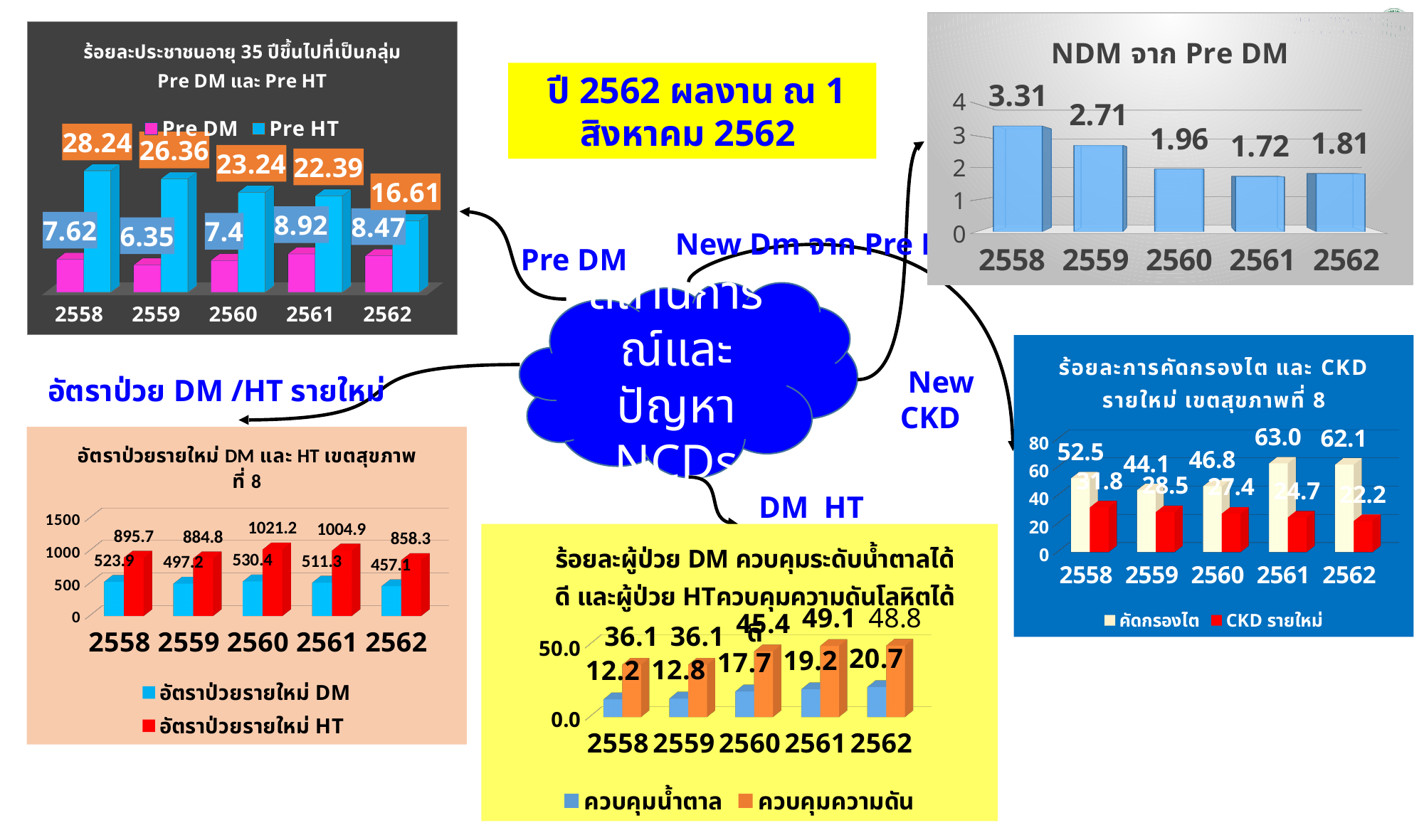
In the top-left chart 'ร้อยละประชาชนอายุ 35 ปีขึ้นไปที่เป็นกลุ่ม Pre DM และ Pre HT', do the Pre HT values rise or fall from 2558 to 2562? fall In the 'NDM จาก Pre DM' chart, what is the value for 2558? 3.31 In the top-left chart 'ร้อยละประชาชนอายุ 35 ปีขึ้นไปที่เป็นกลุ่ม Pre DM และ Pre HT', which year has the highest Pre DM value? 2561 In the 'NDM จาก Pre DM' chart, how many years are shown on the x axis? 5 In the bottom-left chart 'อัตราป่วยรายใหม่ DM และ HT เขตสุขภาพที่ 8', what is the difference between the HT and DM values for 2562? 401.2 In the bottom-middle chart 'ร้อยละผู้ป่วย DM ควบคุมระดับน้ำตาลได้ดี และผู้ป่วย HT ควบคุมความดันโลหิตได้', which year has the highest ควบคุมความดัน value? 2561 In the 'NDM จาก Pre DM' chart, which year has the lowest value? 2561 In the top-left chart 'ร้อยละประชาชนอายุ 35 ปีขึ้นไปที่เป็นกลุ่ม Pre DM และ Pre HT', what is the Pre HT value for 2562? 16.61 In the bottom-left chart 'อัตราป่วยรายใหม่ DM และ HT เขตสุขภาพที่ 8', what is the อัตราป่วยรายใหม่ HT value for 2560? 1021.2 In the right chart 'ร้อยละการคัดกรองไต และ CKD รายใหม่ เขตสุขภาพที่ 8', which is larger: the คัดกรองไต value for 2561 or for 2559? 2561 In the bottom-left chart 'อัตราป่วยรายใหม่ DM และ HT เขตสุขภาพที่ 8', how many series does the legend list? 2 In the bottom-middle chart 'ร้อยละผู้ป่วย DM ควบคุมระดับน้ำตาลได้ดี และผู้ป่วย HT ควบคุมความดันโลหิตได้', what is the ควบคุมน้ำตาล value for 2562? 20.7